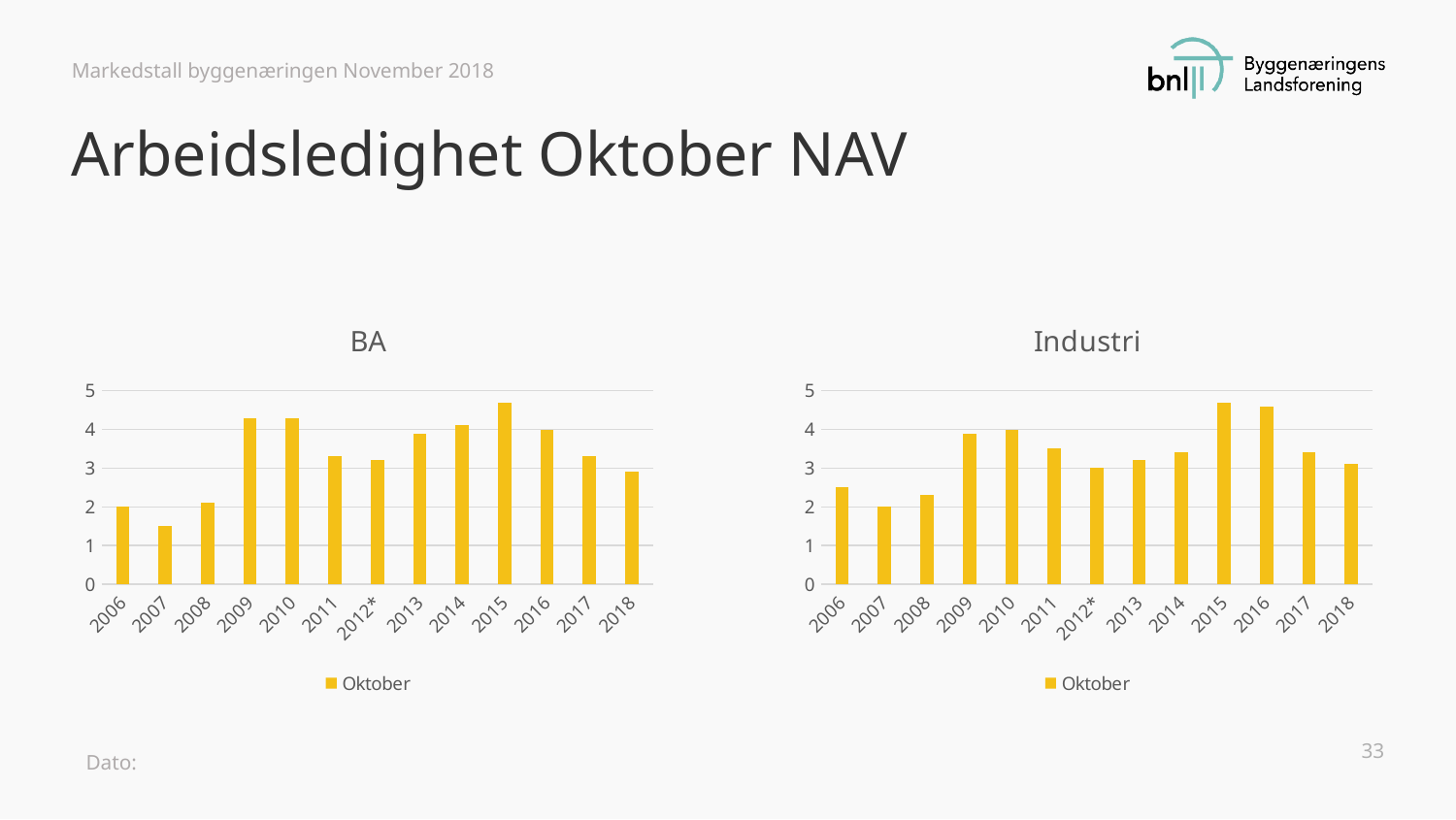
What type of chart is the BA chart? bar chart How many series does the legend of the BA chart list? 1 In the Industri chart, is the value for 2008 greater or less than 3? less In the BA chart, is the value for 2009 greater or less than 4? greater In the Industri chart, which is larger, the value for 2009 or the value for 2012*? 2009 In the BA chart, which is larger, the value for 2010 or the value for 2011? 2010 How many years are shown on the x axis of the Industri chart? 13 In the BA chart, which year has the highest value? 2015 In the Industri chart, which year has the lowest value? 2007 In the BA chart, which year has the lowest value? 2007 In the Industri chart, is the value for 2015 greater or less than 4? greater